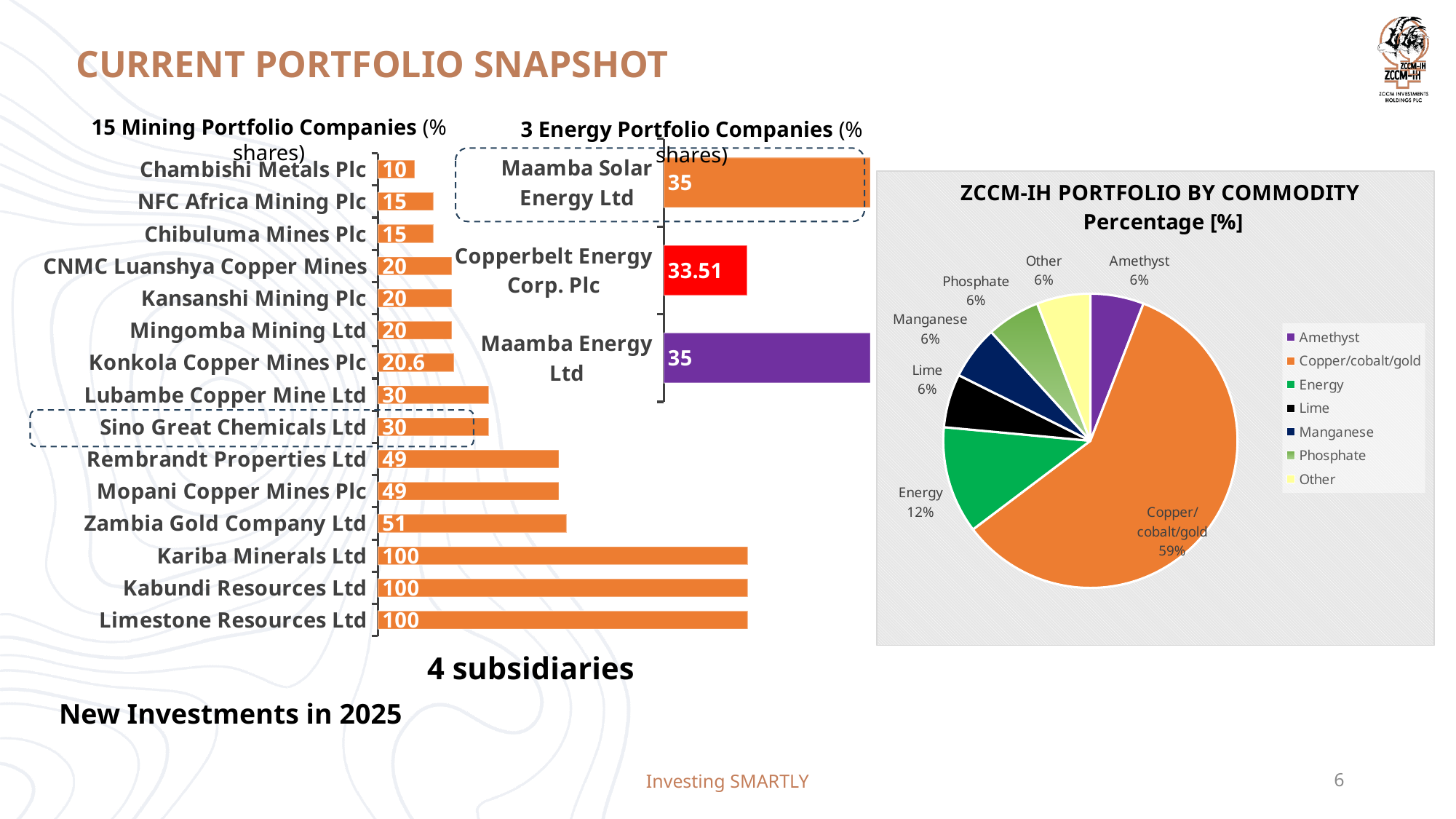
In the '15 Mining Portfolio Companies' chart, what is the value for Konkola Copper Mines Plc? 20.6 In the '3 Energy Portfolio Companies' chart, what is the difference between Maamba Solar Energy Ltd and Copperbelt Energy Corp. Plc? 1.49 In the '15 Mining Portfolio Companies' chart, which is larger, Mopani Copper Mines Plc or Kansanshi Mining Plc? Mopani Copper Mines Plc How many entries does the legend of the 'ZCCM-IH PORTFOLIO BY COMMODITY' pie chart list? 7 In the '15 Mining Portfolio Companies' chart, what is the difference between Lubambe Copper Mine Ltd and NFC Africa Mining Plc? 15 In the '15 Mining Portfolio Companies' chart, which company has the lowest value? Chambishi Metals Plc In the '15 Mining Portfolio Companies' chart, how many companies are plotted? 15 In the '15 Mining Portfolio Companies' chart, what is the value for Zambia Gold Company Ltd? 51 What kind of chart is the 'ZCCM-IH PORTFOLIO BY COMMODITY' chart? Pie chart In the 'ZCCM-IH PORTFOLIO BY COMMODITY' pie chart, what share does Energy have? 12% In the '3 Energy Portfolio Companies' chart, what is the value for Copperbelt Energy Corp. Plc? 33.51 In the 'ZCCM-IH PORTFOLIO BY COMMODITY' pie chart, which commodity has the largest share? Copper/cobalt/gold